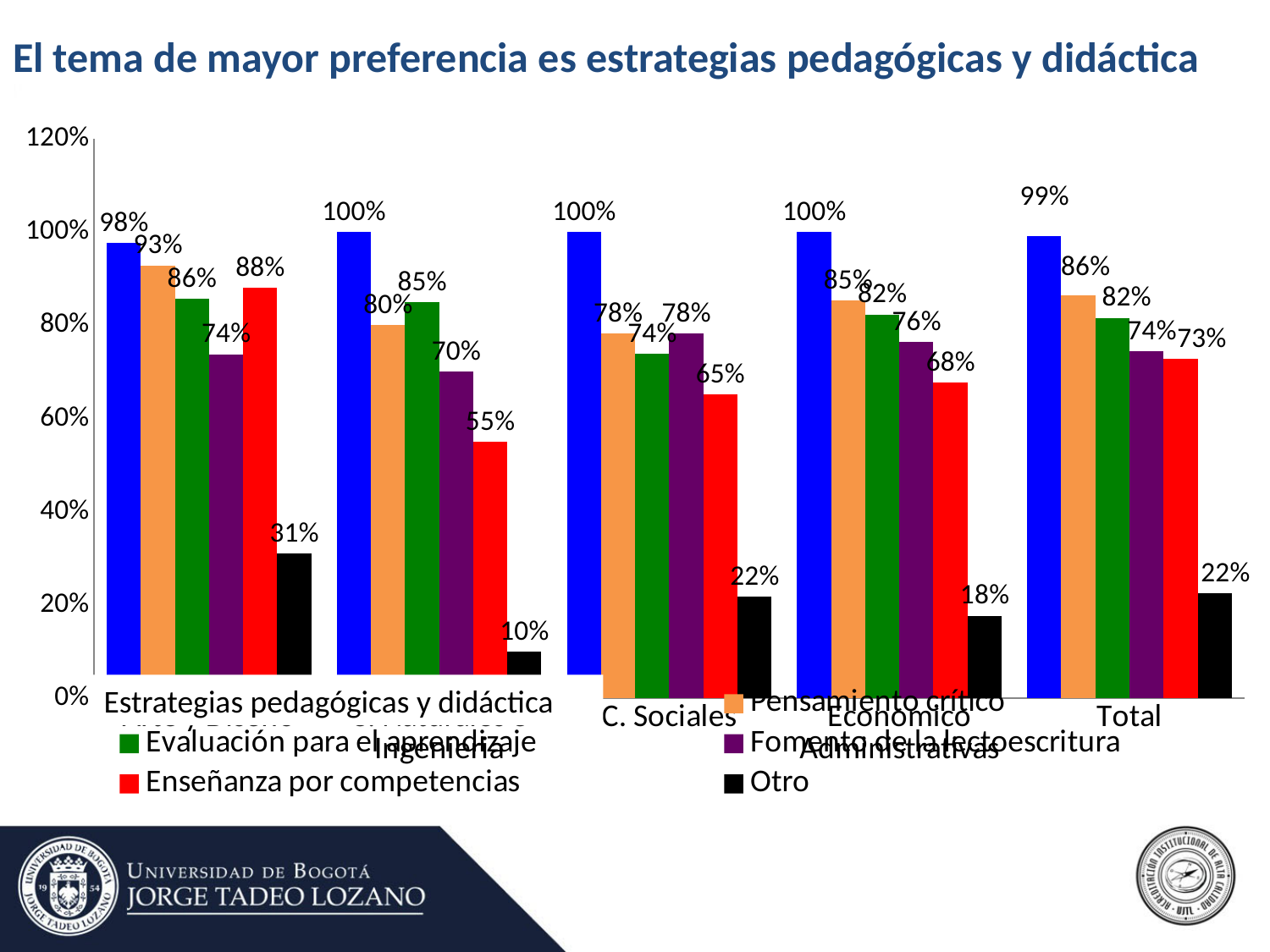
Is the value for Enseñanza por competencias in the Ingeniería group greater or less than 60%? less What is the value for Otro in the Total group? 22% What is the value for Fomento de la lectoescritura in the Total group? 74% What is the value for Estrategias pedagógicas y didáctica in the Ingeniería group? 100% What is the value for Pensamiento crítico in the Económico Administrativas group? 85% What kind of chart is shown on the slide? bar chart How many series does the legend list? 6 In the Ingeniería group, what is the difference between Estrategias pedagógicas y didáctica and Otro? 90 percentage points Which series has the highest value in the Total group? Estrategias pedagógicas y didáctica What is the value for Enseñanza por competencias in the C. Sociales group? 65% Which series has the lowest value in the Ingeniería group? Otro For Enseñanza por competencias, which group has the larger value: Ingeniería or C. Sociales? C. Sociales